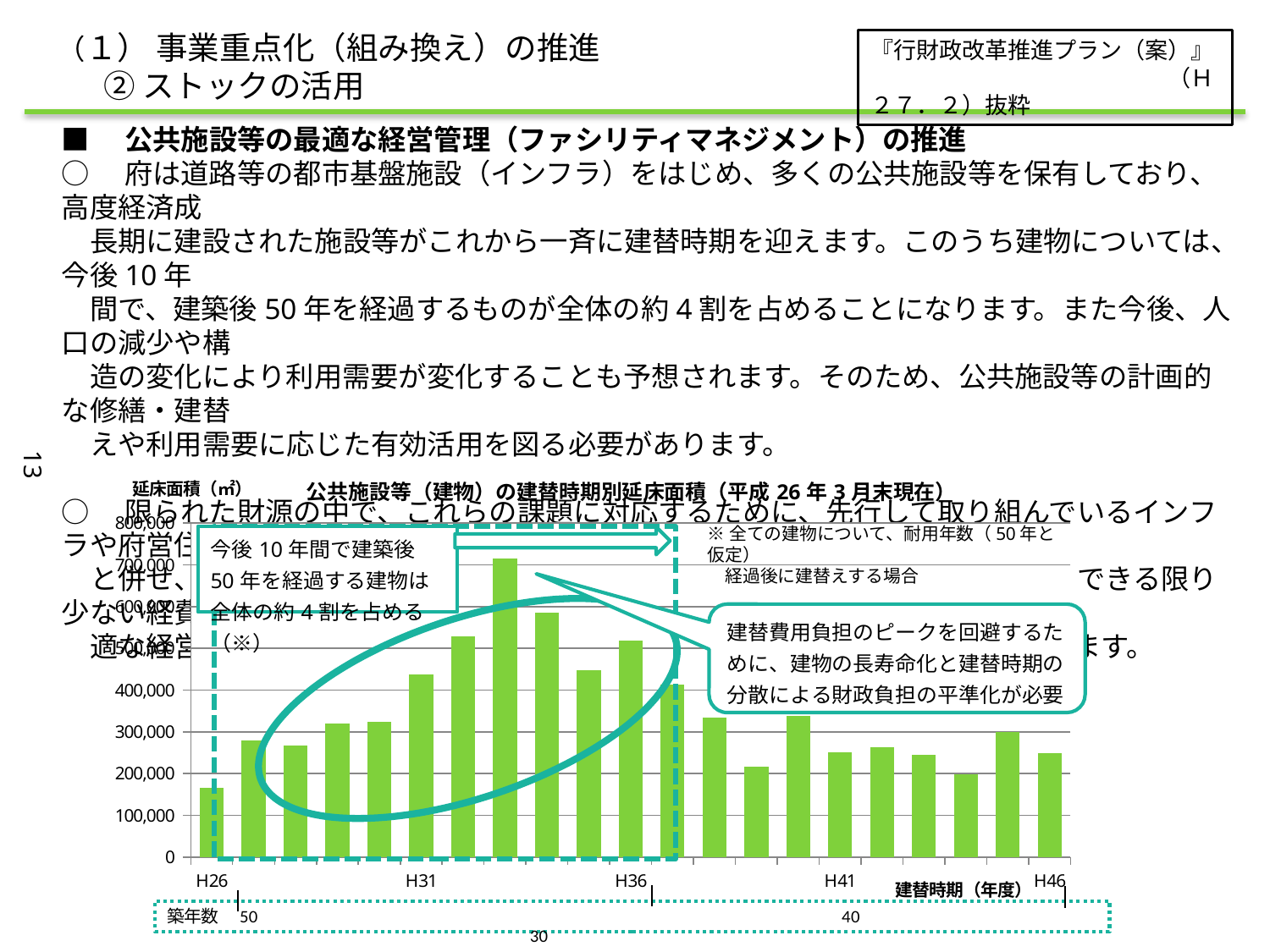
What is the title of the chart? 公共施設等（建物）の建替時期別延床面積（平成26年3月末現在） Is the value for H33 greater or less than 600,000? greater Which year has the shortest bar in the chart? H26 Is the value for H41 greater or less than 300,000? less Which year has the tallest bar in the chart? H33 Do the values rise or fall from H26 to H33? rise What is the label on the vertical axis of the chart? 延床面積（㎡） How many bars are plotted in the chart? 21 Is the value for H26 greater or less than 200,000? less Which is larger, the value for H31 or the value for H36? H36 What type of chart is shown on the slide? bar chart